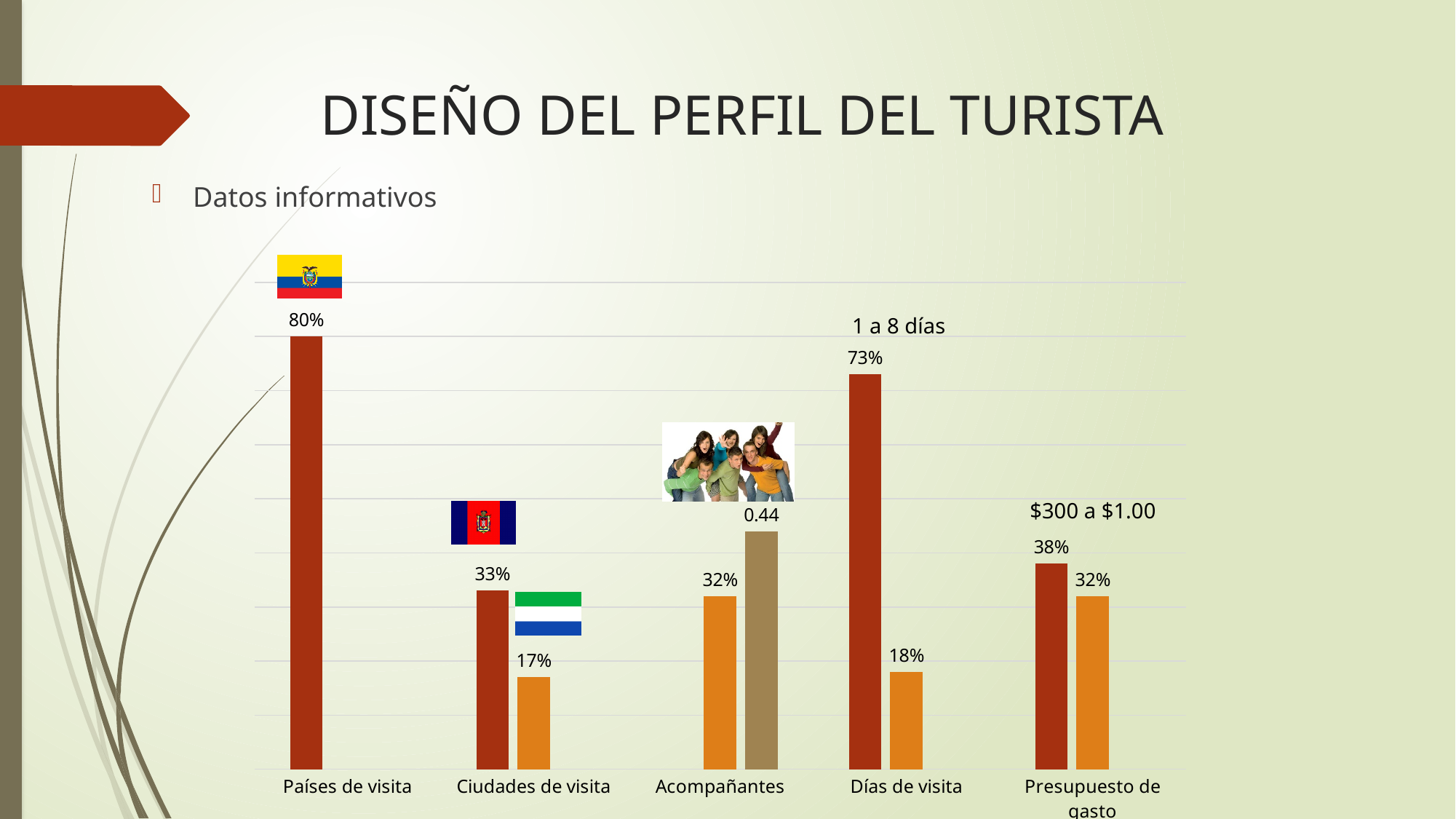
What is the value of the orange bar in the Presupuesto de gasto category? 32% What type of chart is shown on the slide? bar chart Which category contains the tallest bar in the chart? Países de visita What text label appears above the bars in the Días de visita category? 1 a 8 días What is the value of the dark red bar in the Días de visita category? 73% Which is larger: the dark red bar in Ciudades de visita or the dark red bar in Presupuesto de gasto? Presupuesto de gasto What is the difference between the two bars in the Días de visita category (73% and 18%)? 55% What is the value of the second (orange) bar in the Ciudades de visita category? 17% What is the value of the tallest bar in the Países de visita category? 80% How many categories are shown on the x axis of the chart? 5 What is the value of the first (dark red) bar in the Ciudades de visita category? 33% What is the value of the tan bar in the Acompañantes category? 0.44